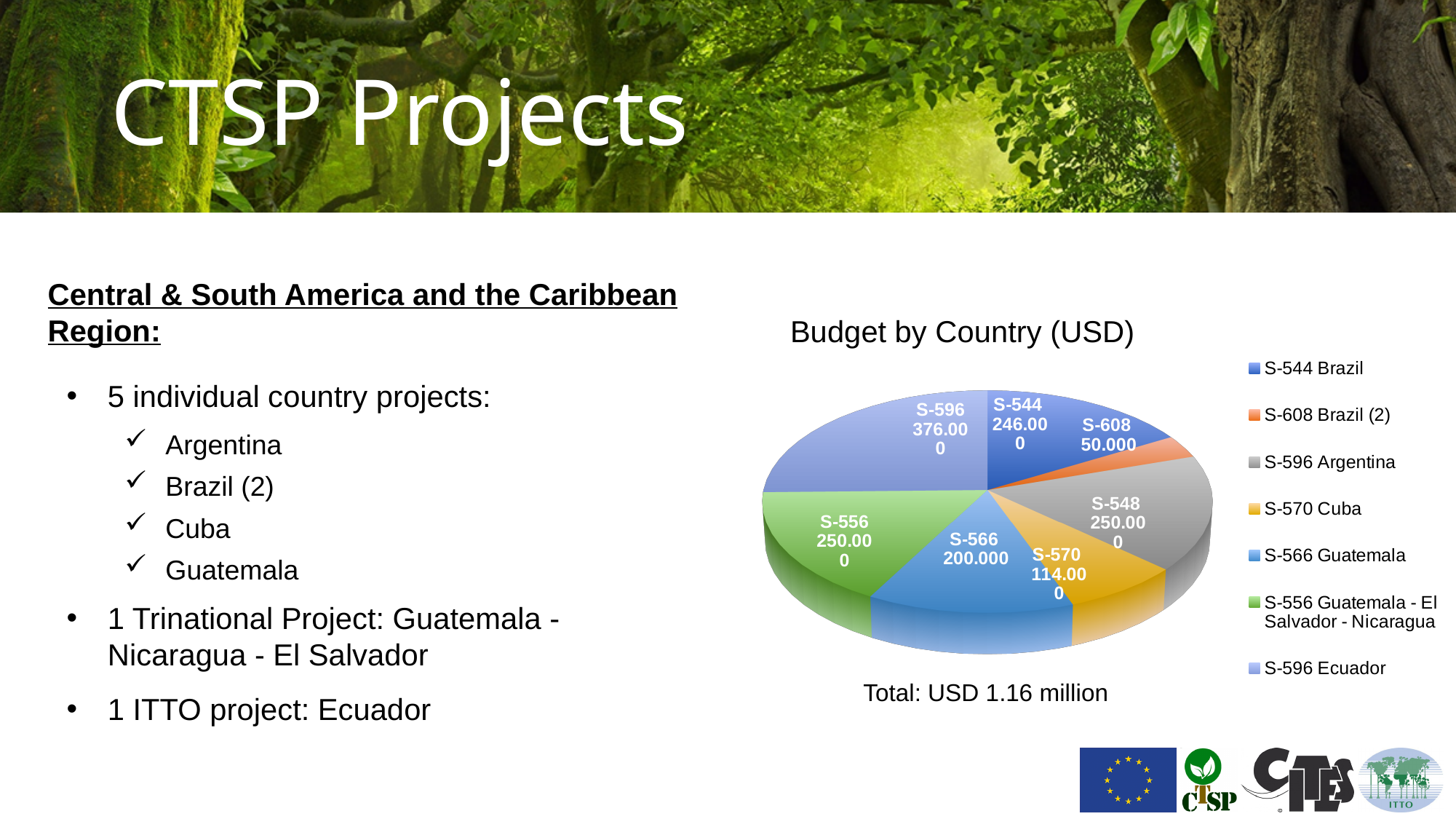
Which project has the smallest slice of the pie? S-608 Brazil (2) What is the budget value shown for S-570 Cuba? 114.000 What is the budget value shown for S-566 Guatemala? 200.000 How many entries does the legend list? 7 Which project has the largest slice of the pie? S-596 Ecuador (376.000) How many slices does the pie chart have? 7 What is the budget value shown for S-608 Brazil (2)? 50.000 What is the title of the chart? Budget by Country (USD) What is the budget value shown for S-544 Brazil? 246.000 What is the difference between the values for S-544 and S-608? 196.000 Which is larger, the value for S-566 Guatemala or S-570 Cuba? S-566 Guatemala What kind of chart is shown on the slide? pie chart